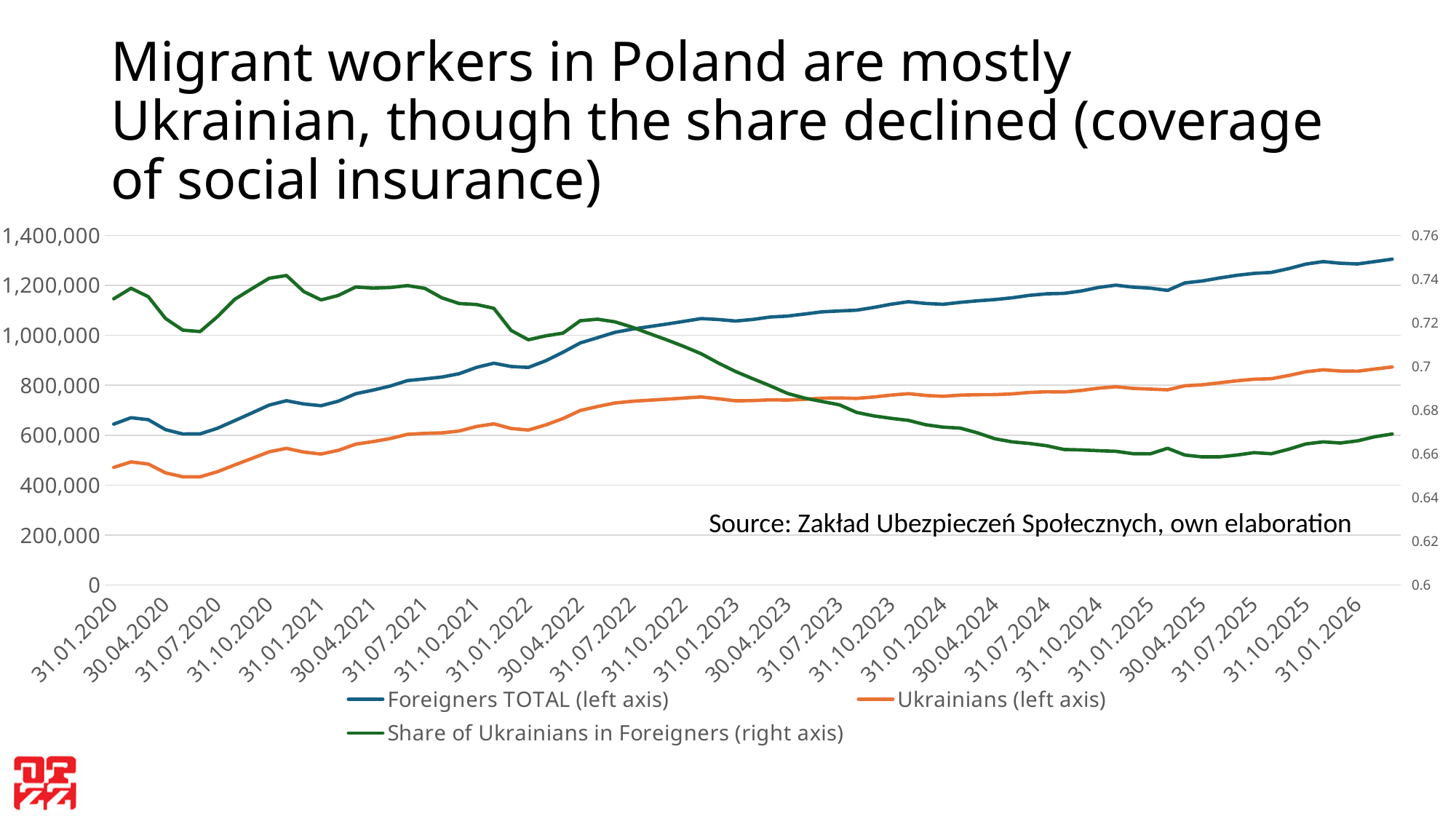
Does the Share of Ukrainians in Foreigners line rise or fall overall from 31.01.2020 to 31.01.2026? Fall How many series does the legend list? 3 Is the Share of Ukrainians in Foreigners at 31.01.2020 greater or less than 0.72? greater Is the value for Ukrainians at 31.01.2020 greater or less than 600,000? less At 31.01.2023, which is larger: Foreigners TOTAL or Ukrainians? Foreigners TOTAL Is the value for Foreigners TOTAL at 31.01.2026 greater or less than 1,200,000? greater What kind of chart is shown on the slide? Line chart Which series is plotted against the right axis? Share of Ukrainians in Foreigners What is the source given on the slide? Zakład Ubezpieczeń Społecznych, own elaboration Does the Foreigners TOTAL line rise or fall overall from 31.01.2020 to 31.01.2026? Rise